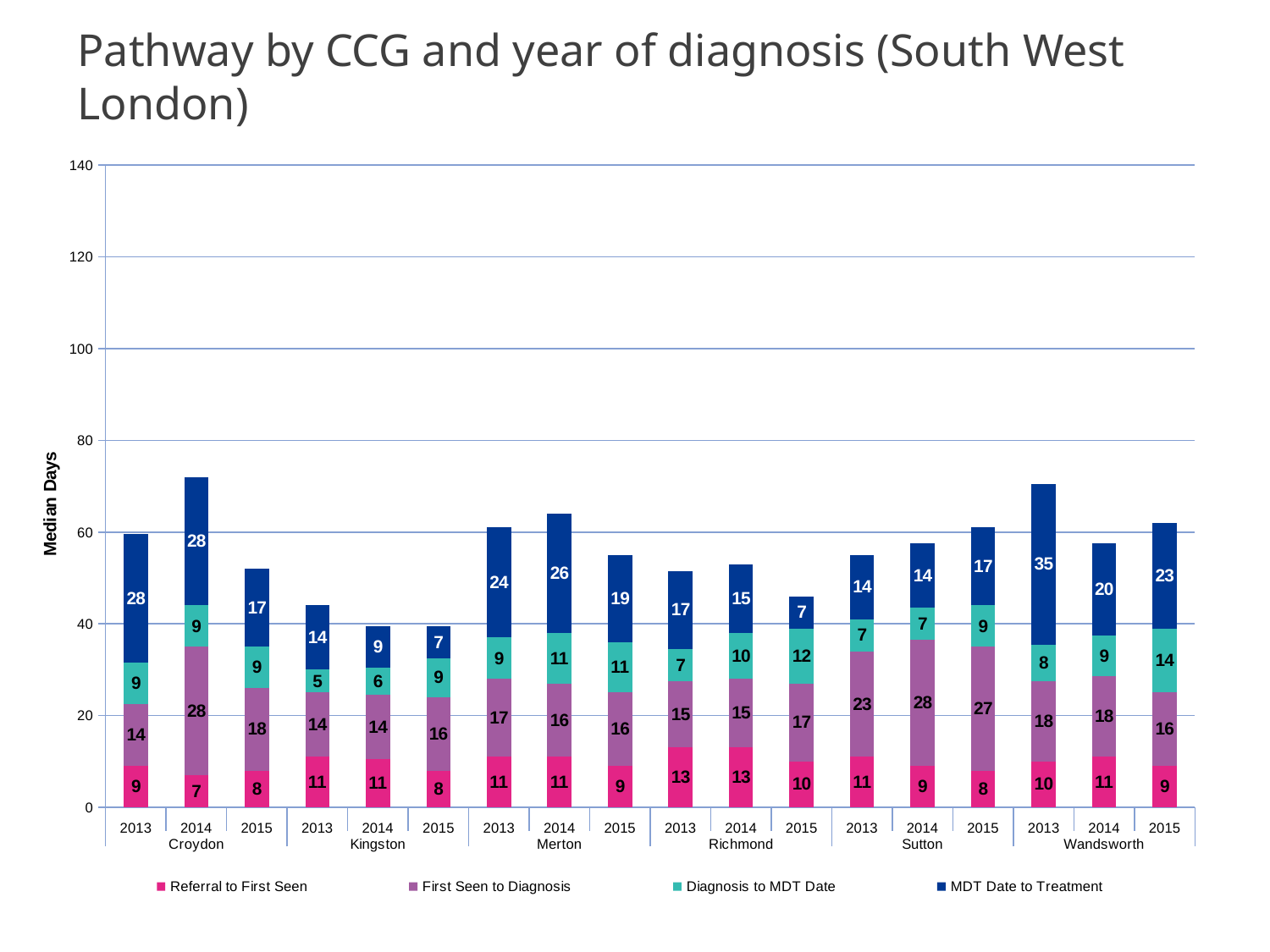
What is the total of the stacked bar for Kingston 2013? 44 Is the total height of the Croydon 2014 bar greater or less than 60? greater What kind of chart is shown on the slide? Stacked bar chart How many stacked bars are plotted in the chart? 18 Which bar has the lowest Diagnosis to MDT Date value? Kingston 2013 What is the difference between the MDT Date to Treatment values for Croydon 2014 and Croydon 2015? 11 Which bar has the highest MDT Date to Treatment value? Wandsworth 2013 Which is larger: the First Seen to Diagnosis value for Sutton 2013 or for Merton 2013? Sutton 2013 How many series does the legend list? 4 What is the First Seen to Diagnosis value for Sutton in 2014? 28 What is the MDT Date to Treatment value for Wandsworth in 2013? 35 What is the Referral to First Seen value for Richmond in 2013? 13